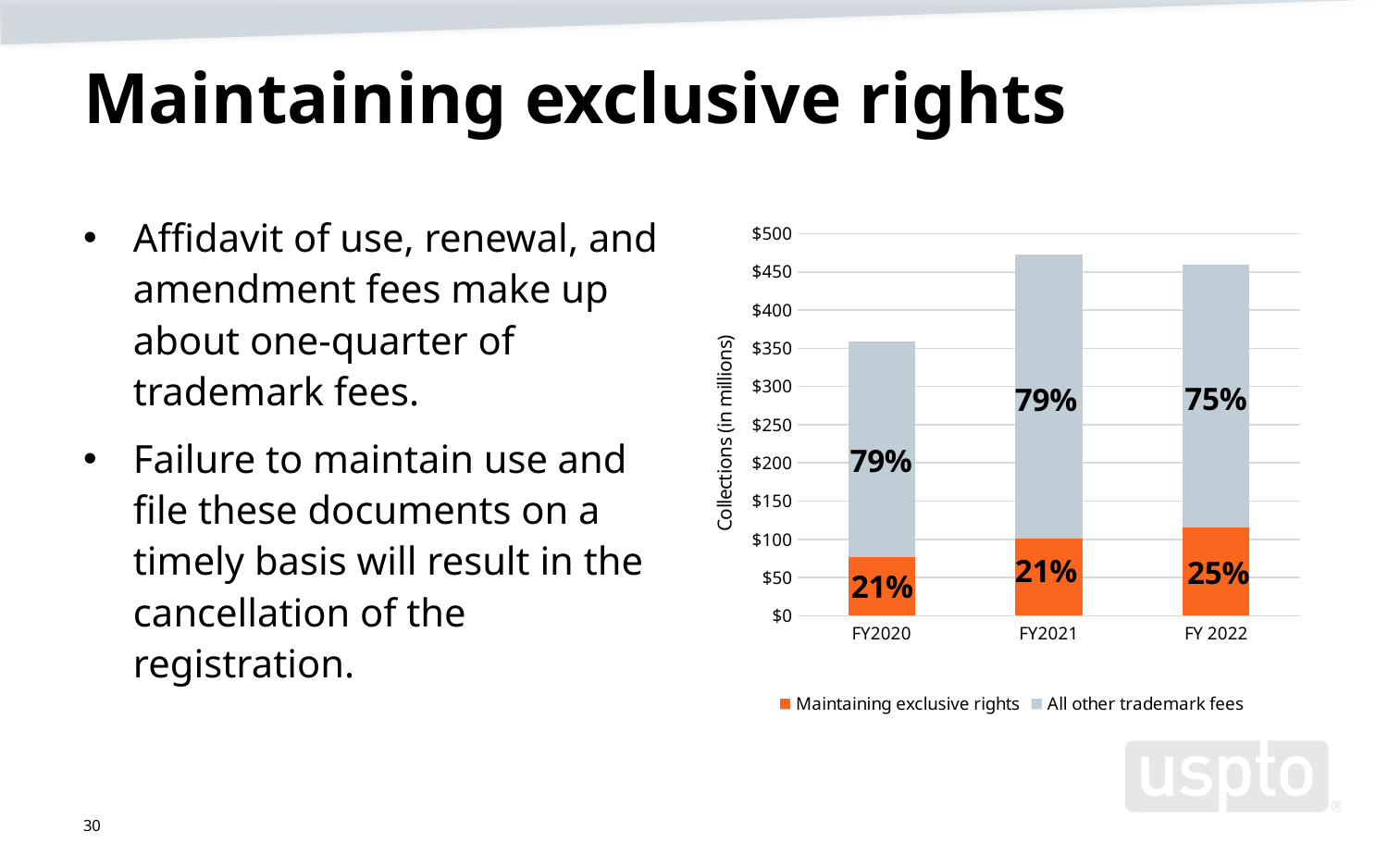
What type of chart is shown on the slide? Stacked bar chart What percentage label is shown on the Maintaining exclusive rights segment for FY2020? 21% What percentage label is shown on the Maintaining exclusive rights segment for FY 2022? 25% Is the total collections bar for FY2021 greater or less than $450? greater What percentage label is shown on the All other trademark fees segment for FY2021? 79% In FY2021, how many percentage points larger is the All other trademark fees share than the Maintaining exclusive rights share? 58 percentage points How many series does the legend list? 2 Which fiscal year has the highest share for Maintaining exclusive rights? FY 2022 Which fiscal year has the lowest total collections bar? FY2020 Is the Maintaining exclusive rights share larger in FY 2022 or in FY2020? FY 2022 Is the total collections bar for FY2020 greater or less than $400? less How many fiscal years are shown on the x axis? 3